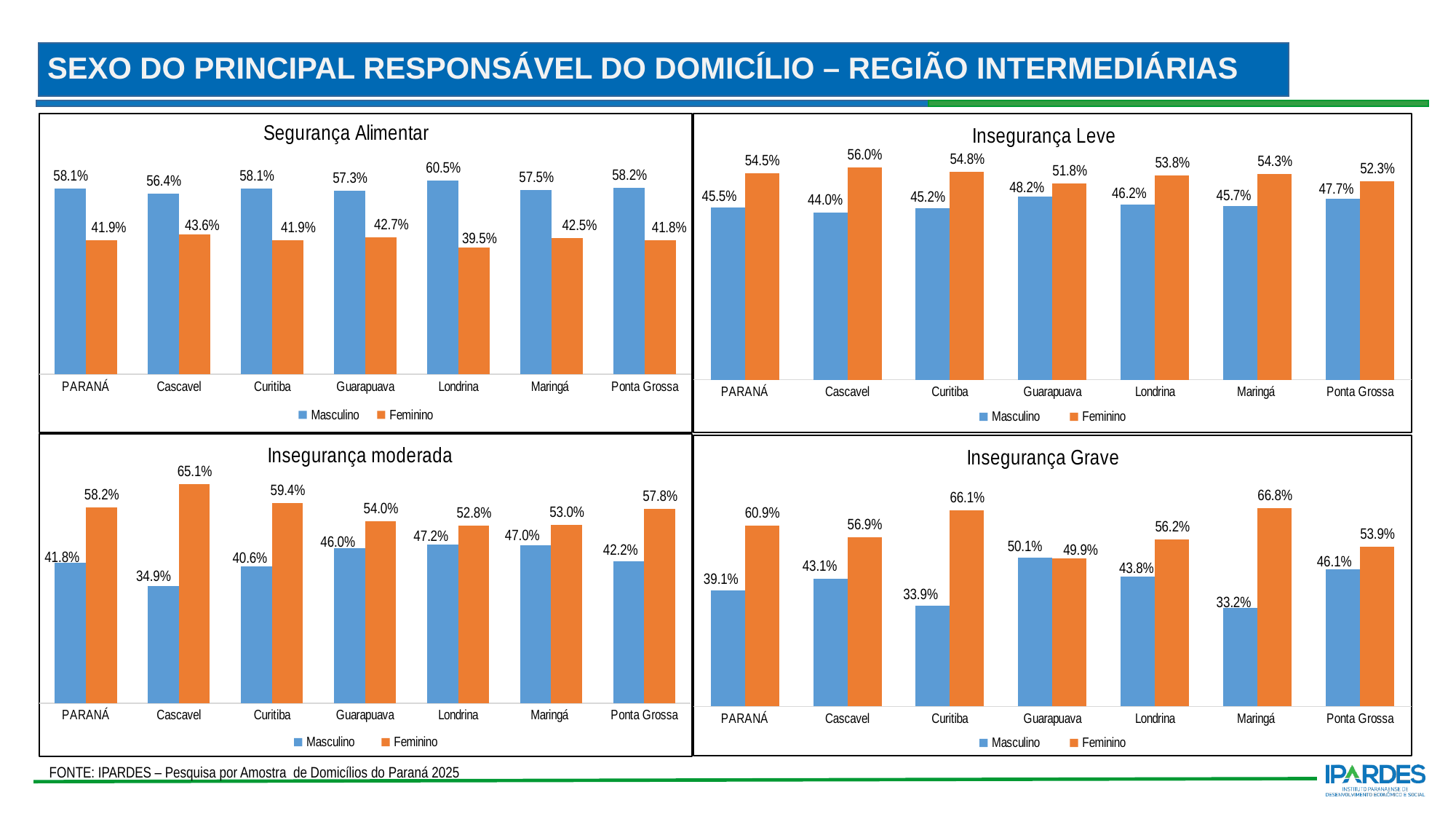
In the Insegurança Grave chart, which category has the lowest Masculino value? Maringá How many series does the legend of the Insegurança Leve chart list? 2 In the Insegurança Grave chart, what is the Feminino value for Maringá? 66.8% In the Insegurança Grave chart, which is larger for Guarapuava, Masculino or Feminino? Masculino What kind of chart is the Insegurança moderada chart? Bar chart What are the two legend entries in the Insegurança Grave chart? Masculino and Feminino In the Segurança Alimentar chart, what is the Masculino value for Londrina? 60.5% How many categories are shown on the x axis of the Segurança Alimentar chart? 7 In the Insegurança Leve chart, what is the difference between the Feminino and Masculino values for Cascavel? 12.0 percentage points In the Insegurança moderada chart, what is the Masculino value for Cascavel? 34.9% In the Segurança Alimentar chart, what is the difference between the Masculino and Feminino values for PARANÁ? 16.2 percentage points In the Insegurança moderada chart, which category has the highest Feminino value? Cascavel